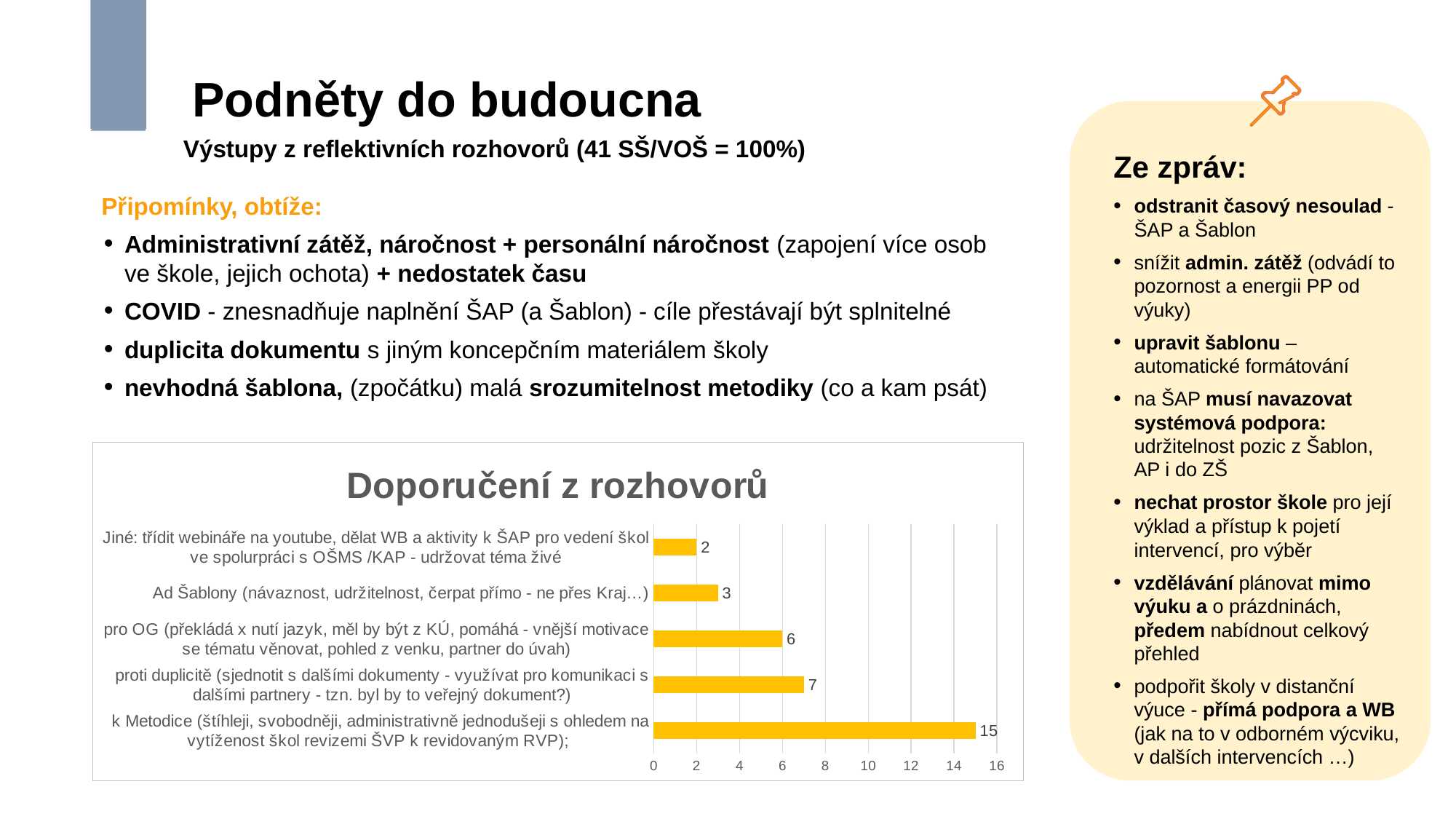
How many categories does the chart show? 5 Which category has the highest value? k Metodice What is the title of the chart on the slide? Doporučení z rozhovorů What is the value for the category "proti duplicitě"? 7 What is the value for the category "Ad Šablony"? 3 What is the value for the category "k Metodice"? 15 Which has a larger value, "pro OG" or "Ad Šablony"? pro OG What is the difference between the values for "k Metodice" and "proti duplicitě"? 8 What is the value for the category "pro OG"? 6 What type of chart is shown on the slide? bar chart Which category has the lowest value? Jiné What is the value for the category "Jiné"? 2